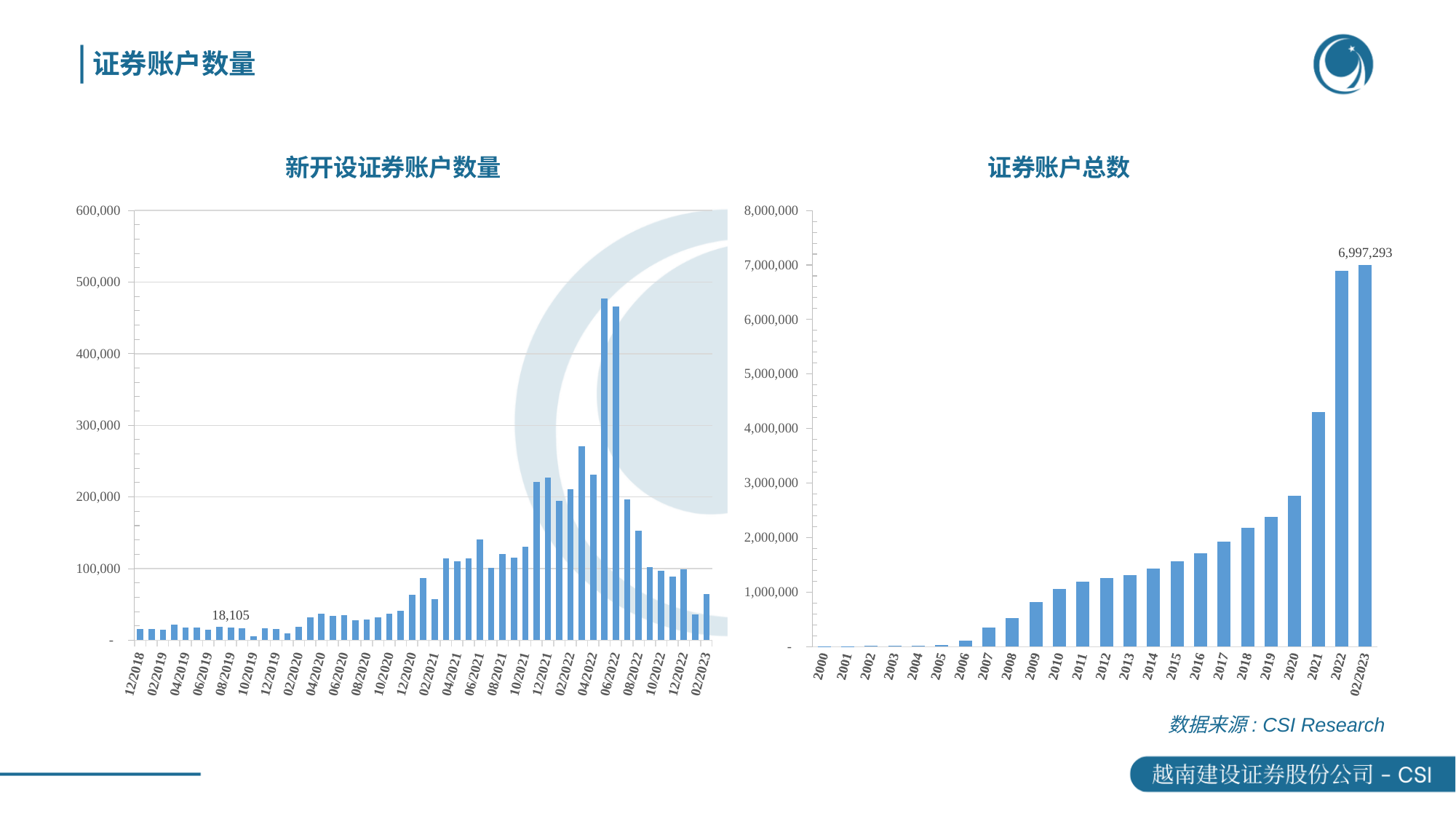
In the chart titled 证券账户总数, what is the value for 02/2023? 6,997,293 In the chart titled 证券账户总数, which is larger, the value for 2022 or the value for 2020? 2022 In the chart titled 新开设证券账户数量, is the value for 02/2023 greater or less than 100,000? less In the chart titled 证券账户总数, do the values generally rise or fall from 2000 to 02/2023? rise In the chart titled 证券账户总数, which category has the highest value? 02/2023 In the chart titled 证券账户总数, is the value for 2021 greater or less than 4,000,000? greater In the chart titled 证券账户总数, how many categories are shown on the x axis? 24 In the chart titled 证券账户总数, is the value for 2019 greater or less than 3,000,000? less What data source is cited below the charts? CSI Research What is the title of the chart on the right side of the slide? 证券账户总数 What kind of chart is the one titled 新开设证券账户数量? bar chart